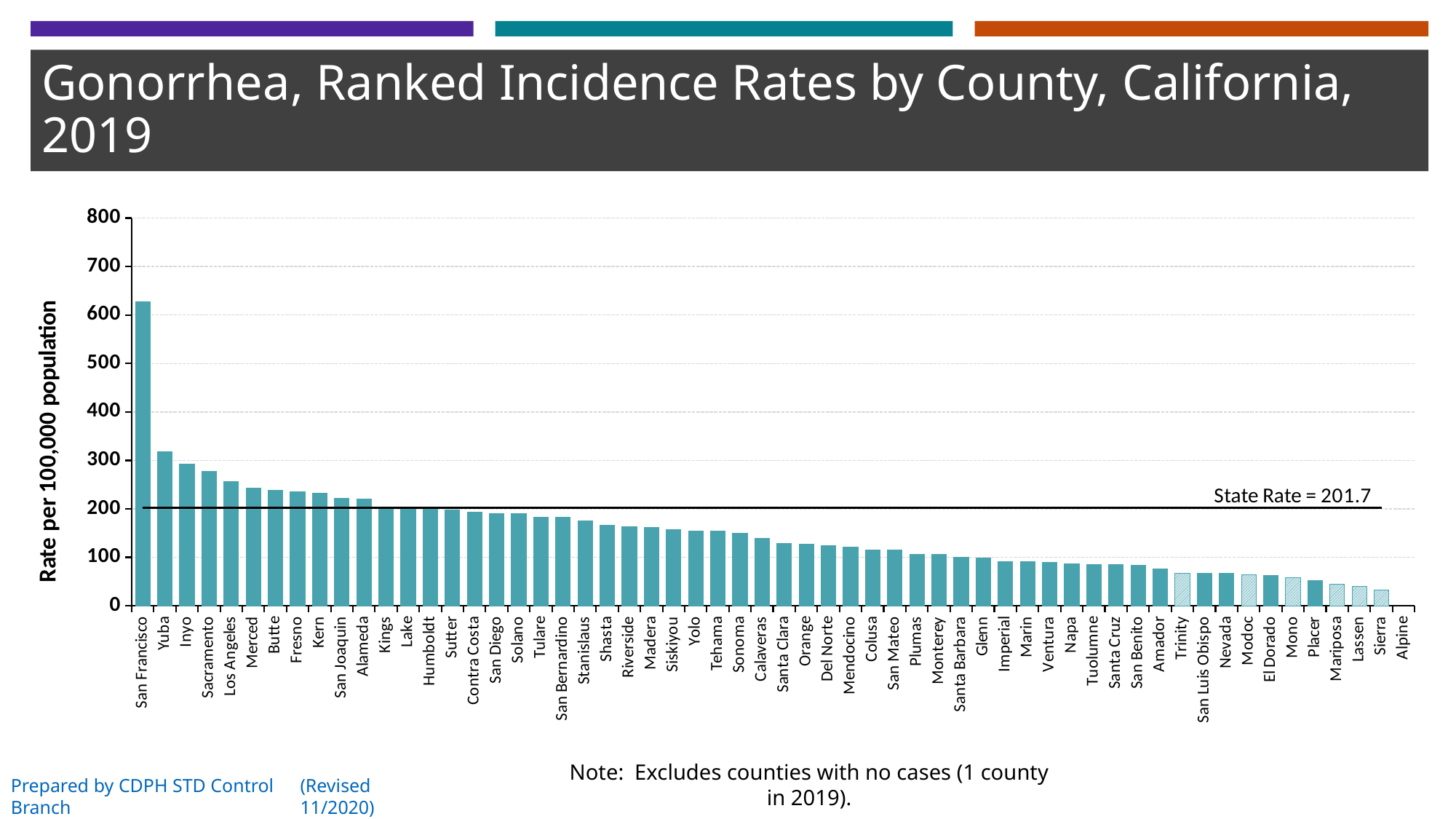
Which county has the highest gonorrhea incidence rate in the chart? San Francisco Is the value for Los Angeles greater or less than 200? greater Which county with a plotted bar has the lowest gonorrhea incidence rate? Sierra What is the state rate shown by the horizontal line on the chart? 201.7 What type of chart is shown on the slide? Bar chart What is the label of the y axis? Rate per 100,000 population Is the value for San Francisco greater or less than 600? greater Is the value for Placer greater or less than 100? less Which county has a higher rate, Yuba or Inyo? Yuba Do the bar values rise or fall from left to right along the x axis? Fall